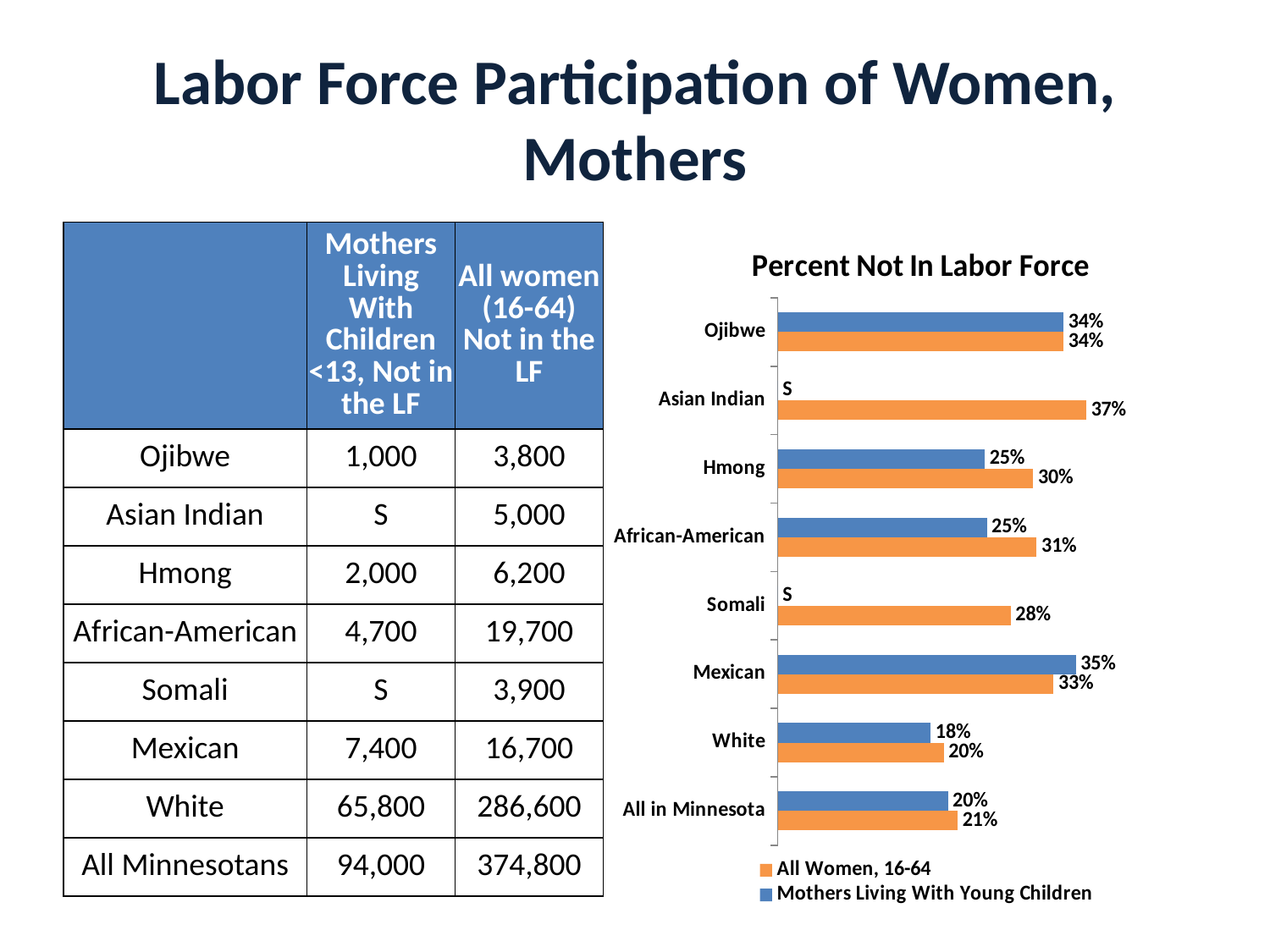
For Hmong, which is larger: the All Women, 16-64 value or the Mothers Living With Young Children value? All Women, 16-64 What label is shown in place of the Mothers Living With Young Children bar for Asian Indian? S Which category has the highest value for All Women, 16-64? Asian Indian What is the value for All Women, 16-64 for Somali? 28% Which category has the lowest value for Mothers Living With Young Children? White How many categories are shown on the chart? 8 What is the value for Mothers Living With Young Children for Mexican? 35% What is the value for All Women, 16-64 for Asian Indian? 37% What type of chart is shown on the slide? bar chart What is the difference between the All Women, 16-64 value and the Mothers Living With Young Children value for African-American? 6% How many series does the chart legend list? 2 What is the title of the chart? Percent Not In Labor Force